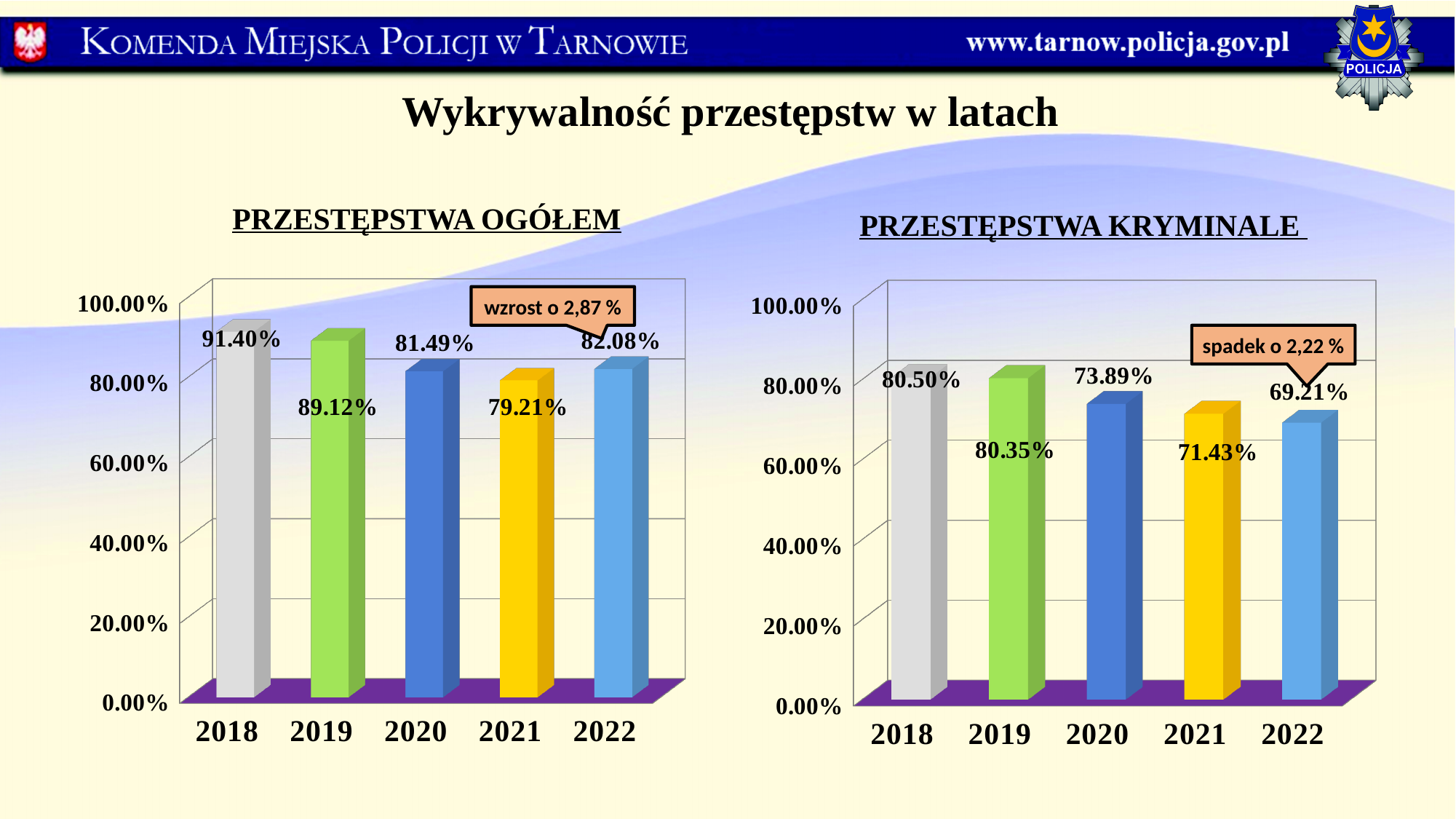
What kind of chart is the PRZESTĘPSTWA OGÓŁEM chart? bar chart In the PRZESTĘPSTWA OGÓŁEM chart, which year has the highest value? 2018 In the PRZESTĘPSTWA KRYMINALE chart, do the values rise or fall from 2018 to 2022? fall In the PRZESTĘPSTWA OGÓŁEM chart, what is the difference between the values for 2018 and 2019? 2.28% How many years are shown on the x axis of the PRZESTĘPSTWA KRYMINALE chart? 5 In the PRZESTĘPSTWA KRYMINALE chart, what is the value for 2022? 69.21% In the PRZESTĘPSTWA OGÓŁEM chart, what is the value for 2018? 91.40% In the PRZESTĘPSTWA KRYMINALE chart, what is the difference between the values for 2021 and 2022? 2.22% In the PRZESTĘPSTWA OGÓŁEM chart, what is the value for 2021? 79.21% In the PRZESTĘPSTWA KRYMINALE chart, which year has the lowest value? 2022 In the PRZESTĘPSTWA OGÓŁEM chart, which is larger, the value for 2020 or the value for 2022? 2022 In the PRZESTĘPSTWA KRYMINALE chart, what is the value for 2020? 73.89%